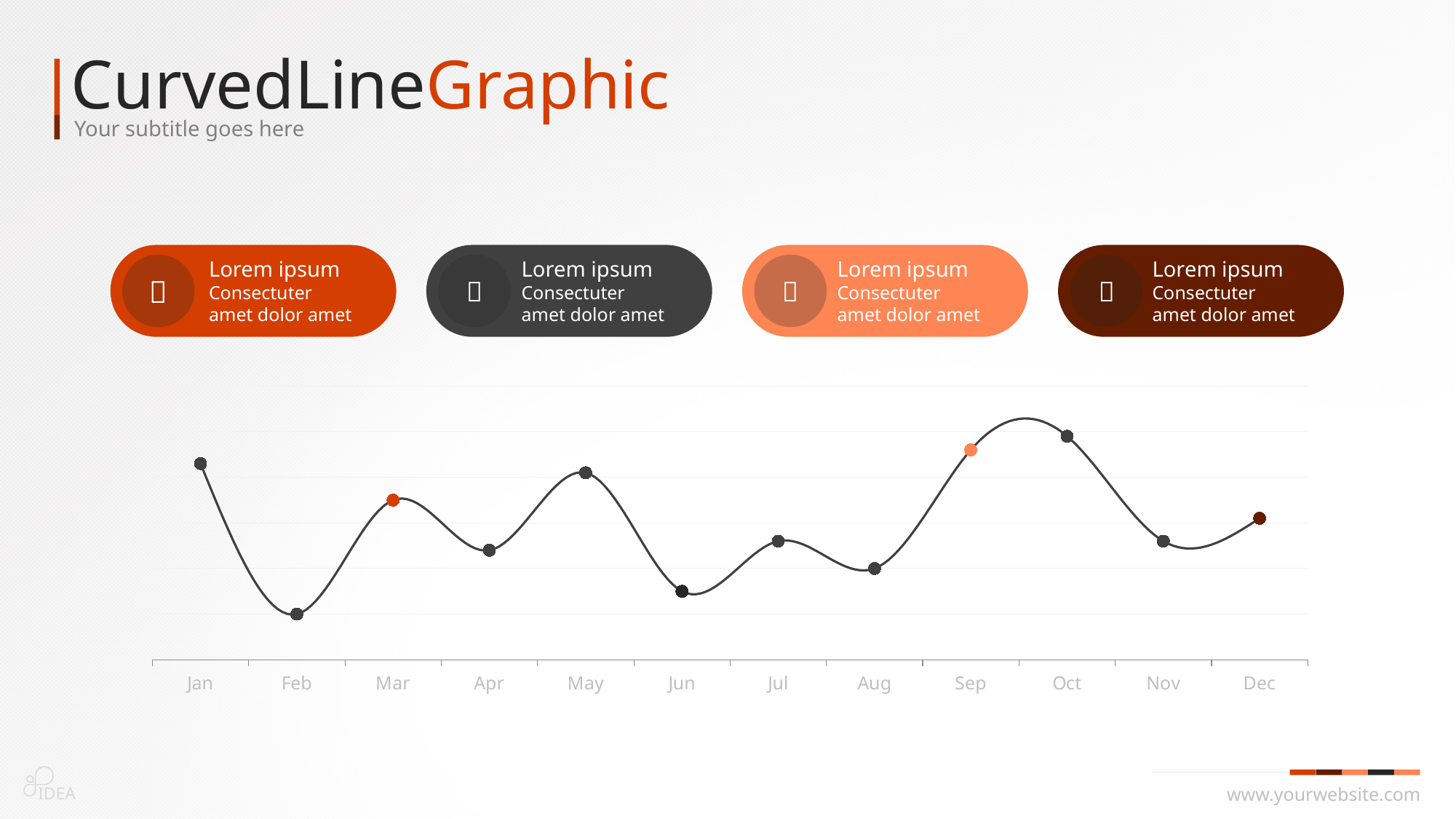
Which month has the lowest plotted point on the line chart? Feb What kind of chart is shown on the slide? line chart Does the line rise or fall from Jan to Feb? fall Which is higher on the line chart, the point for May or the point for Apr? May Which is higher on the line chart, the point for Jul or the point for Jun? Jul Does the line rise or fall from Oct to Nov? fall How many data points are plotted on the line chart? 12 What is the title of the slide containing the chart? Curved Line Graphic Which is higher on the line chart, the point for Jan or the point for Feb? Jan Does the line rise or fall from Aug to Oct? rise What is the first month label on the x axis of the chart? Jan Which month has the highest plotted point on the line chart? Oct